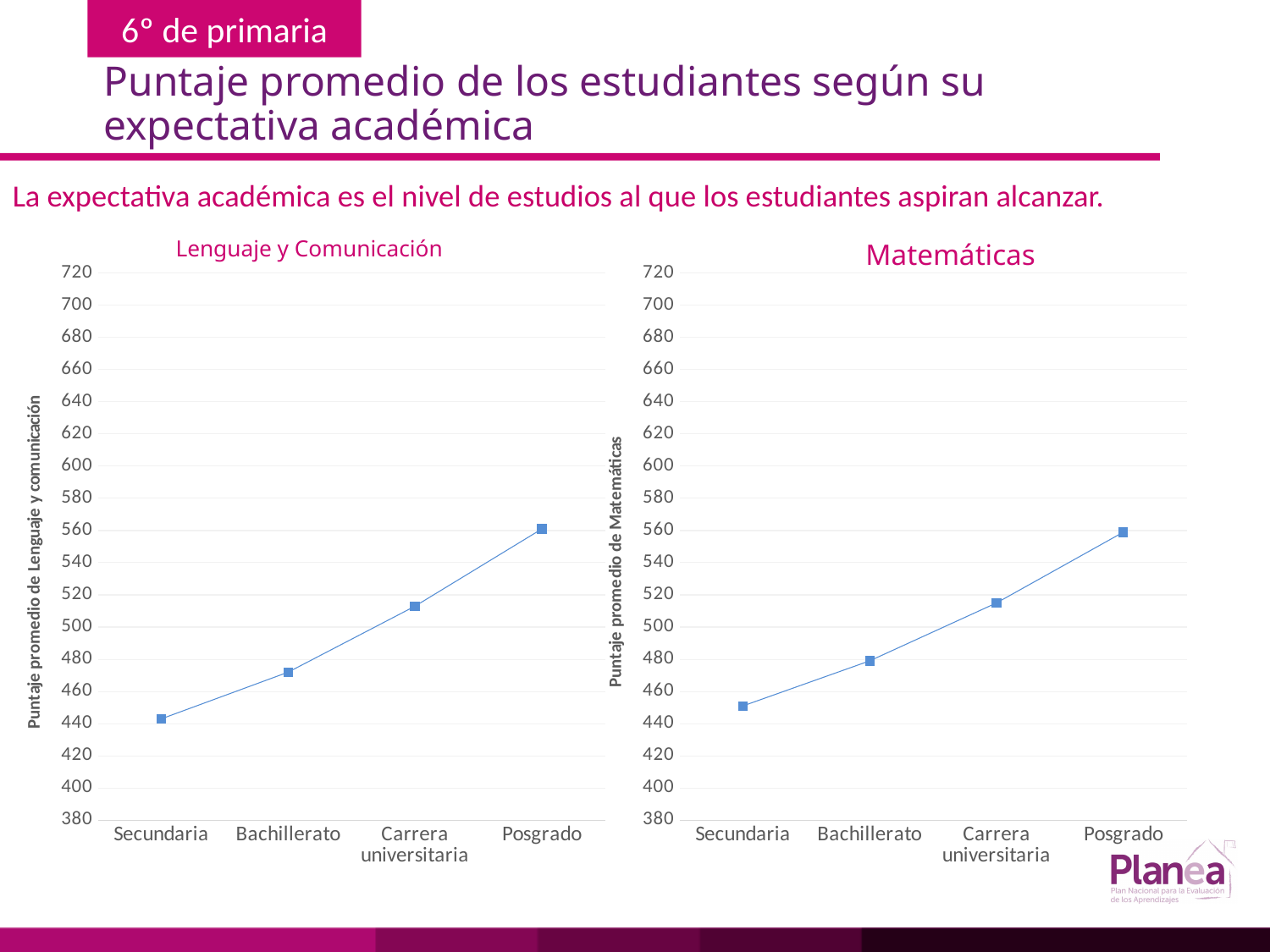
How many academic expectation categories are shown on the x axis of the Lenguaje y Comunicación chart? 4 In the Matemáticas chart, which is larger, the value for Carrera universitaria or the value for Bachillerato? Carrera universitaria In the Matemáticas chart, do the average scores rise or fall from Secundaria to Posgrado? rise In the Matemáticas chart, is the value for Bachillerato greater or less than 500? less In the Lenguaje y Comunicación chart, is the value for Posgrado greater or less than 540? greater In the Matemáticas chart, is the value for Posgrado greater or less than 540? greater In the Matemáticas chart, which academic expectation category has the lowest average score? Secundaria What is the y-axis title of the Matemáticas chart? Puntaje promedio de Matemáticas In the Lenguaje y Comunicación chart, which academic expectation category has the highest average score? Posgrado What kind of chart is the Lenguaje y Comunicación chart? line chart